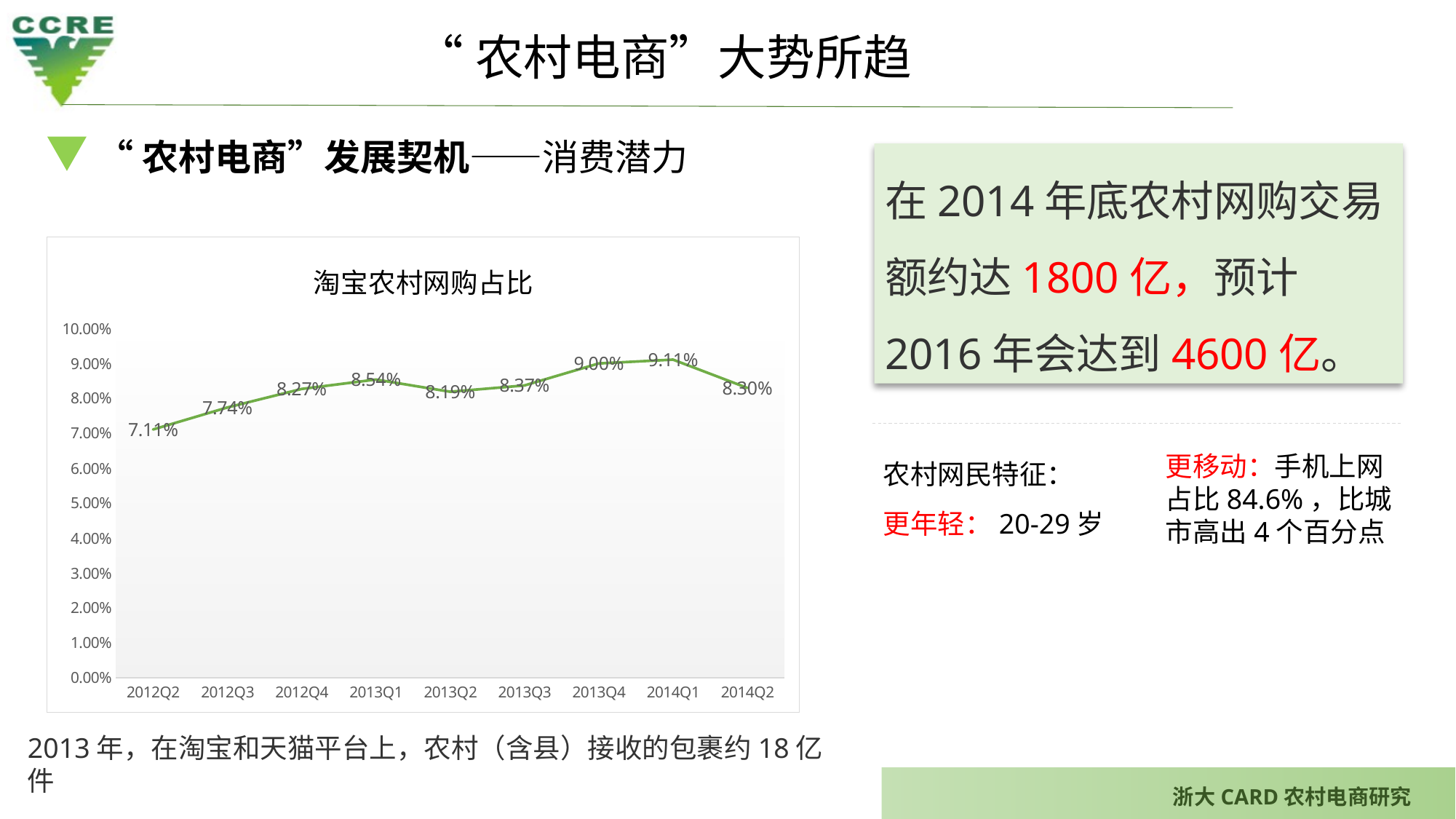
How many quarters are plotted on the x axis of the chart? 9 What is the title of the chart on the slide? 淘宝农村网购占比 What type of chart is shown on the slide? line chart Does the value rise or fall from 2014Q1 to 2014Q2? fall What is the difference between the values for 2014Q1 and 2012Q2? 2.00% Which is larger, the value for 2013Q1 or the value for 2013Q2? 2013Q1 What is the value for 2013Q4 in the chart? 9.00% What is the value for 2014Q2 in the chart? 8.30% Which quarter has the lowest value in the chart? 2012Q2 Is the value for 2013Q3 greater or less than 9.00%? less Which quarter has the highest value in the chart? 2014Q1 What is the value for 2012Q2 in the chart? 7.11%